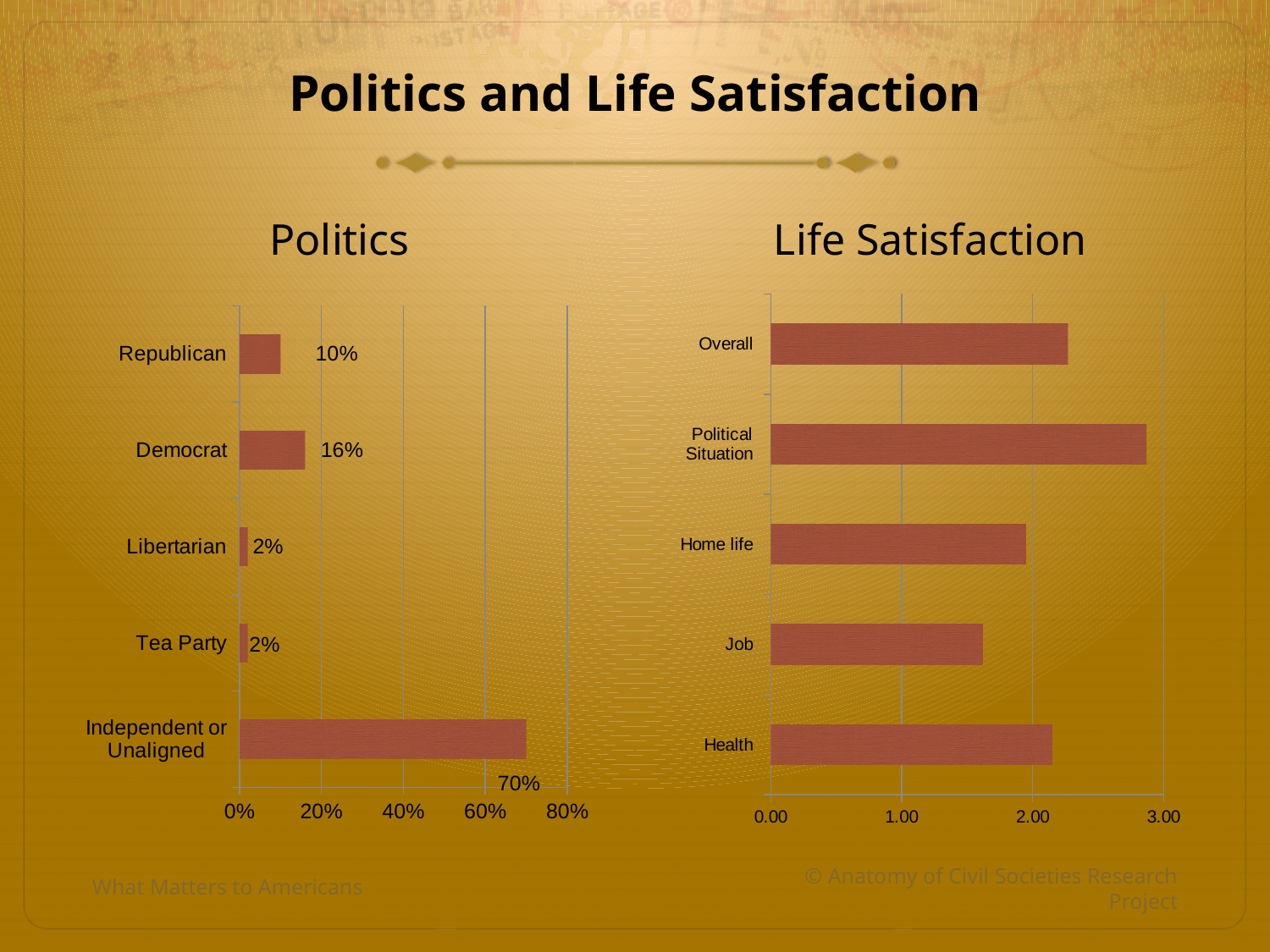
In the Politics chart, what is the difference between the Democrat and Republican values? 6% In the Politics chart, what percentage is shown for Republican? 10% In the Politics chart, which is larger, Democrat or Republican? Democrat In the Life Satisfaction chart, is the value for Job greater or less than 2.00? less In the Life Satisfaction chart, which category has the highest value? Political Situation In the Life Satisfaction chart, which category has the lowest value? Job How many categories are shown in the Politics chart? 5 In the Politics chart, what percentage is shown for Independent or Unaligned? 70% What kind of chart is the Life Satisfaction chart? Bar chart In the Politics chart, which category has the highest value? Independent or Unaligned In the Politics chart, what percentage is shown for Democrat? 16% In the Life Satisfaction chart, is the value for Political Situation greater or less than 2.00? greater